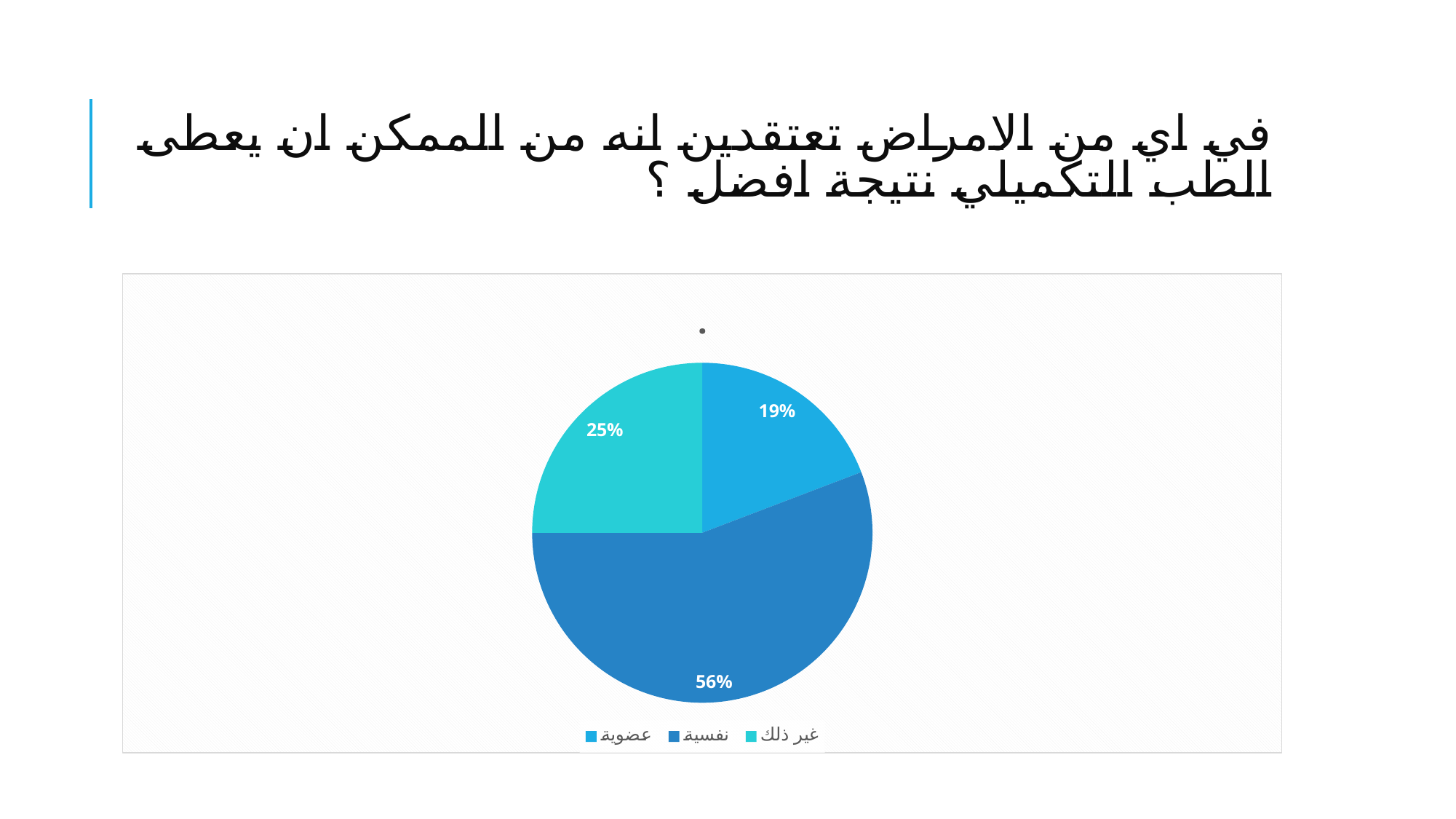
Which category has the largest slice of the pie? نفسية What are the three legend entries of the pie chart? عضوية, نفسية, غير ذلك What percentage does the slice for عضوية show? 19% What is the difference in percentage points between the نفسية slice and the غير ذلك slice? 31 What percentage does the slice for نفسية show? 56% Which is larger, the slice for غير ذلك or the slice for عضوية? غير ذلك How many entries does the legend list? 3 Which category has the smallest slice of the pie? عضوية What is the difference in percentage points between the غير ذلك slice and the عضوية slice? 6 How many slices does the pie chart have? 3 What kind of chart is shown on the slide? pie chart What percentage does the slice for غير ذلك show? 25%